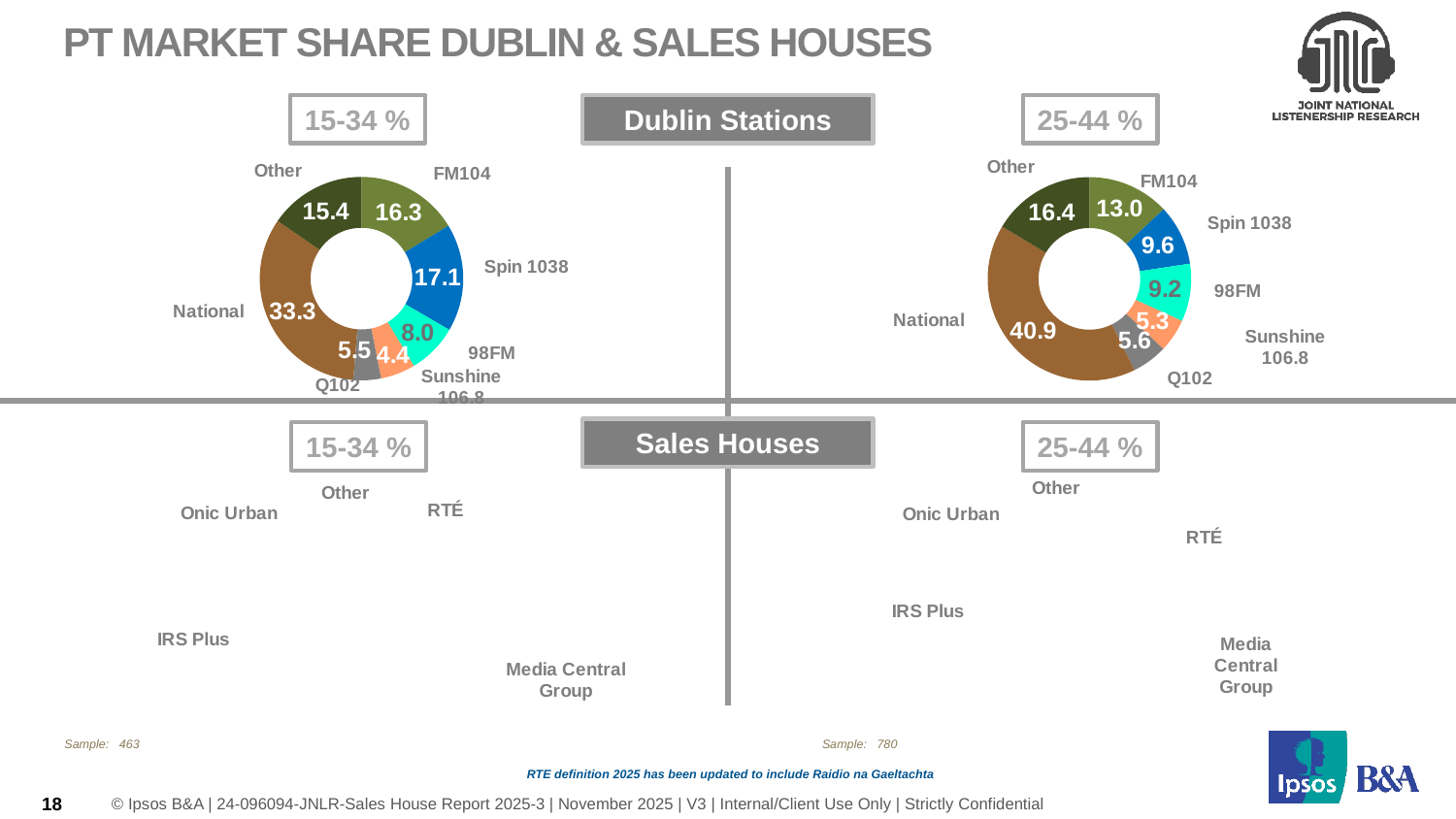
In the Dublin Stations 15-34 chart, which is larger, FM104 or Spin 1038? Spin 1038 In the Dublin Stations 15-34 chart, what is the value for National? 33.3 In the Dublin Stations 25-44 chart, what share does Q102 hold? 5.6 In the Dublin Stations 25-44 chart, what is the difference between Spin 1038 and 98FM? 0.4 In the Dublin Stations 25-44 chart, what is the value for Sunshine 106.8? 5.3 In the Dublin Stations 25-44 chart, what is the value for FM104? 13.0 What type of chart is used for the Dublin Stations 15-34 data? Donut (pie) chart In the Dublin Stations 15-34 chart, which station has the smallest share? Q102 In the Dublin Stations 15-34 chart, what is the difference between National and Other? 17.9 In the Dublin Stations 15-34 chart, what is the value for Spin 1038? 17.1 How many segments does the Dublin Stations 25-44 chart have? 7 In the Dublin Stations 25-44 chart, which station has the largest share? National